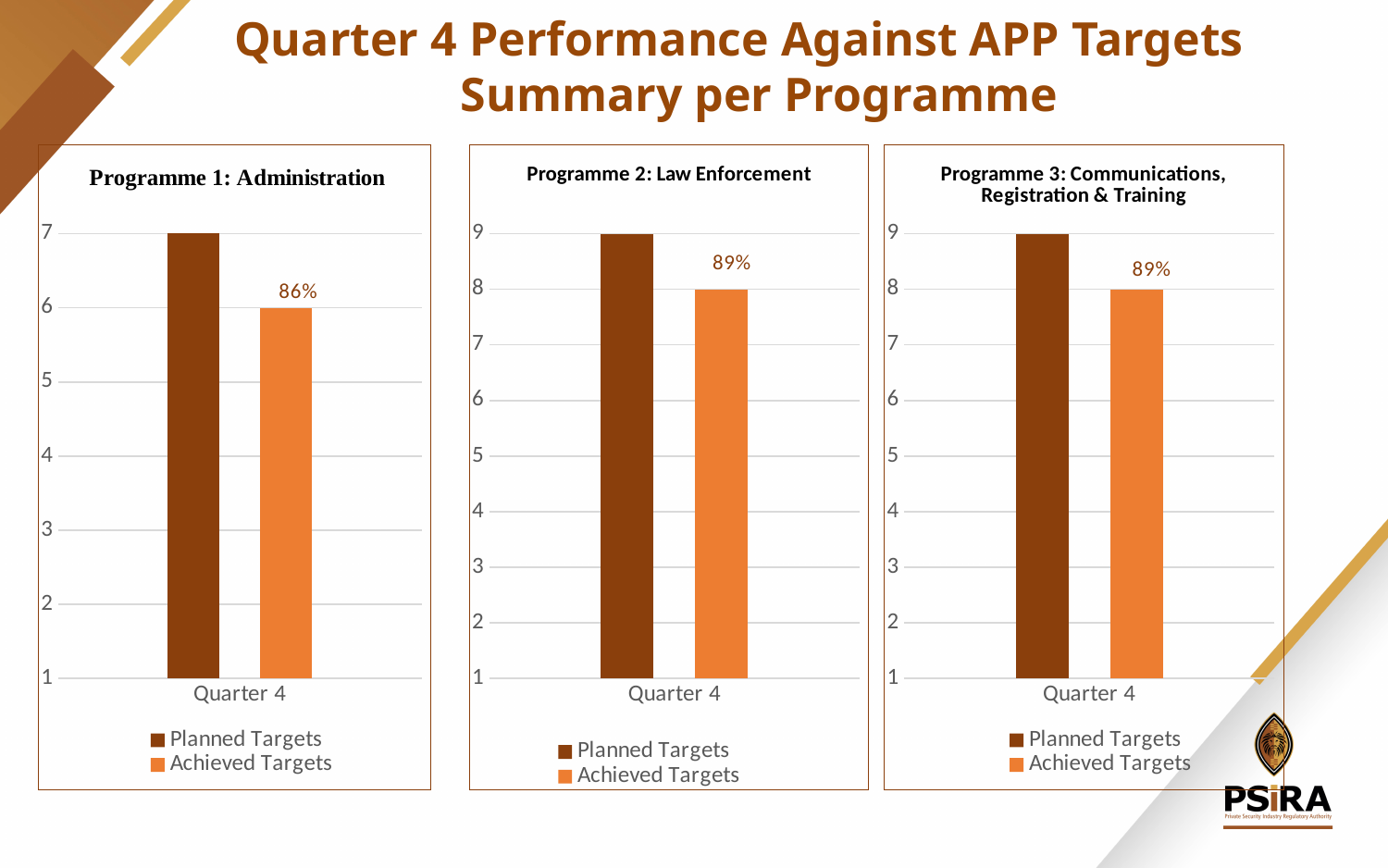
In the Programme 1: Administration chart, what is the value of the Planned Targets bar for Quarter 4? 7 In the Programme 1: Administration chart, what is the value of the Achieved Targets bar for Quarter 4? 6 What type of chart is the Programme 3: Communications, Registration & Training chart? Bar chart In the Programme 2: Law Enforcement chart, what is the value of the Achieved Targets bar? 8 In the Programme 2: Law Enforcement chart, which series has the higher value, Planned Targets or Achieved Targets? Planned Targets In the Programme 1: Administration chart, what colour are the Achieved Targets bars? Orange In the Programme 2: Law Enforcement chart, what is the value of the Planned Targets bar? 9 In the Programme 1: Administration chart, what is the difference between Planned Targets and Achieved Targets? 1 In the Programme 3: Communications, Registration & Training chart, what percentage label is shown above the Achieved Targets bar? 89% In the Programme 1: Administration chart, what percentage label is shown above the Achieved Targets bar? 86% In the Programme 3: Communications, Registration & Training chart, which series has the lower value? Achieved Targets How many series does the legend list in the Programme 2: Law Enforcement chart? 2